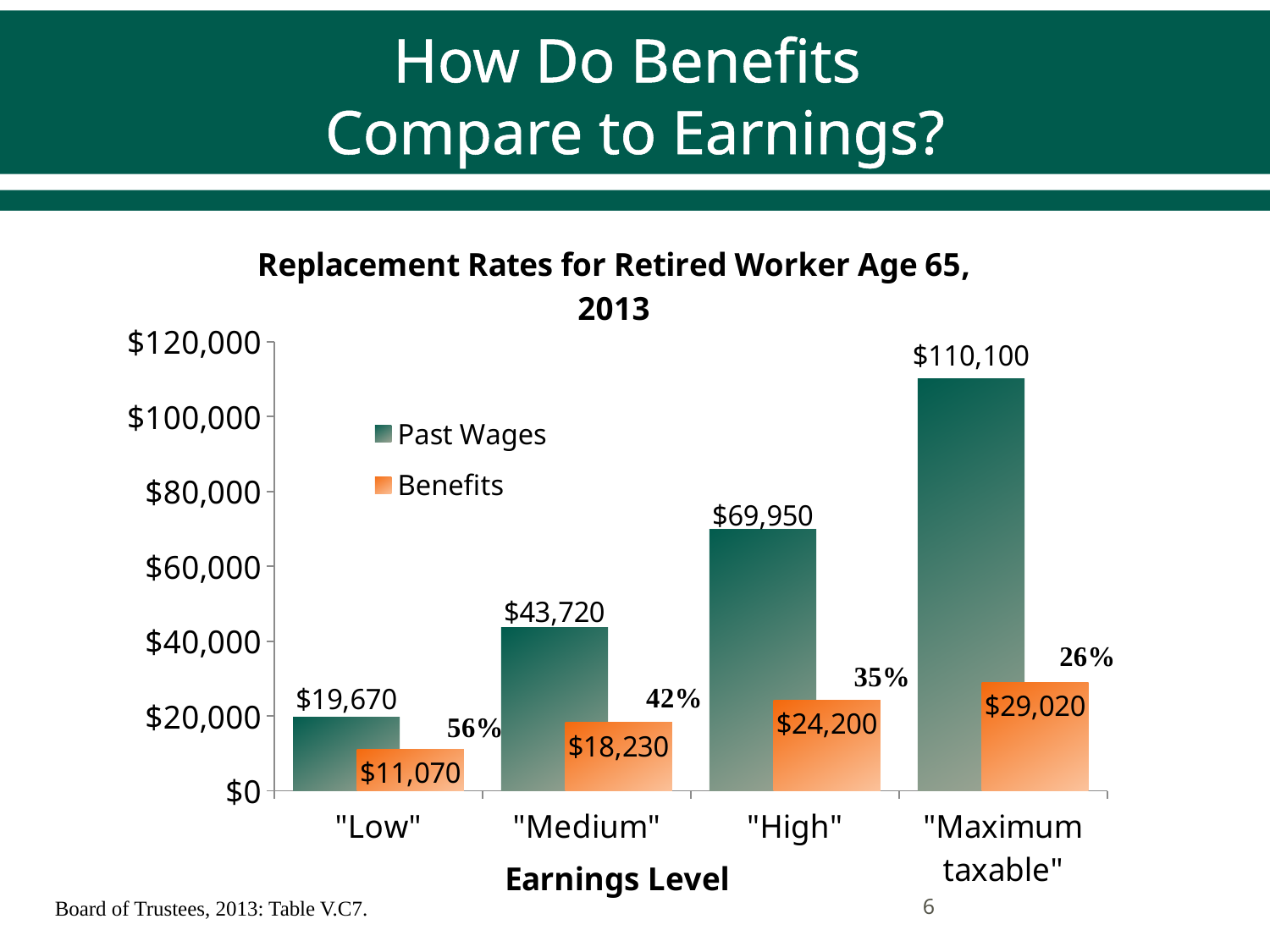
What is the Past Wages value for the "Medium" earnings level? $43,720 How many series does the legend list? 2 Which is larger: Benefits for "Medium" or Benefits for "Maximum taxable"? Benefits for "Maximum taxable" How many earnings levels are shown on the x axis? 4 What is the Benefits value for the "Low" earnings level? $11,070 What kind of chart is shown on the slide? Bar chart Which earnings level has the lowest Benefits value? "Low" What replacement rate percentage is shown for the "Medium" earnings level? 42% What is the difference between Past Wages and Benefits for the "High" earnings level? $45,750 What is the Past Wages value for the "Maximum taxable" earnings level? $110,100 What is the Benefits value for the "High" earnings level? $24,200 Which earnings level has the highest Past Wages value? "Maximum taxable"